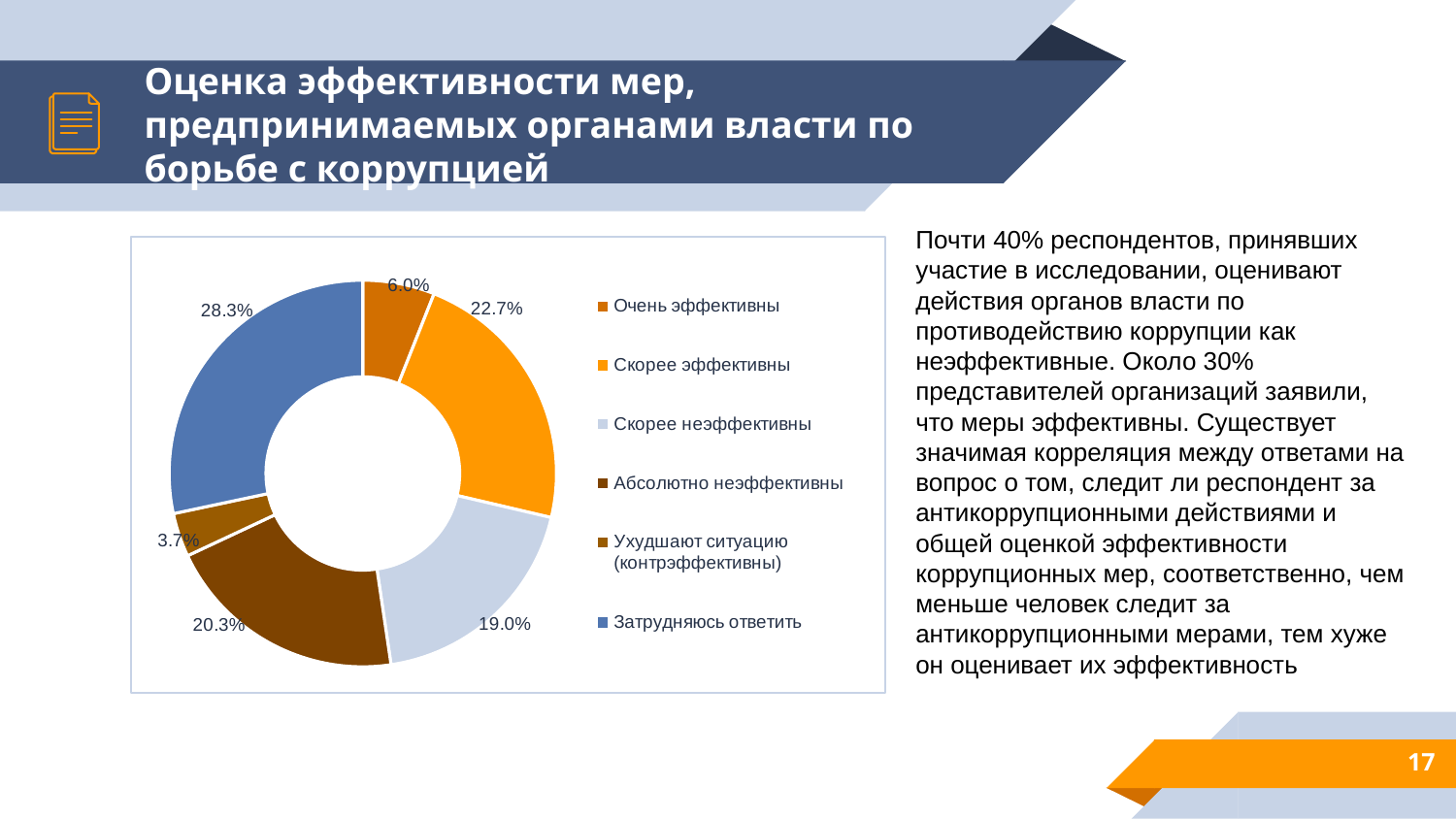
How many categories are shown in the chart? 6 Which category has the smallest share of the chart? Ухудшают ситуацию (контрэффективны) What percentage corresponds to «Ухудшают ситуацию (контрэффективны)»? 3.7% What is the difference between «Скорее эффективны» and «Очень эффективны»? 16.7% Which is larger: «Абсолютно неэффективны» or «Скорее неэффективны»? Абсолютно неэффективны What is the combined share of «Очень эффективны» and «Скорее эффективны»? 28.7% What percentage of respondents answered «Затрудняюсь ответить»? 28.3% Which legend entry is shown in blue? Затрудняюсь ответить What type of chart is shown on the slide? Doughnut (pie) chart What share of respondents chose «Скорее эффективны»? 22.7% What is the value for «Абсолютно неэффективны»? 20.3% Which category has the largest share of the chart? Затрудняюсь ответить